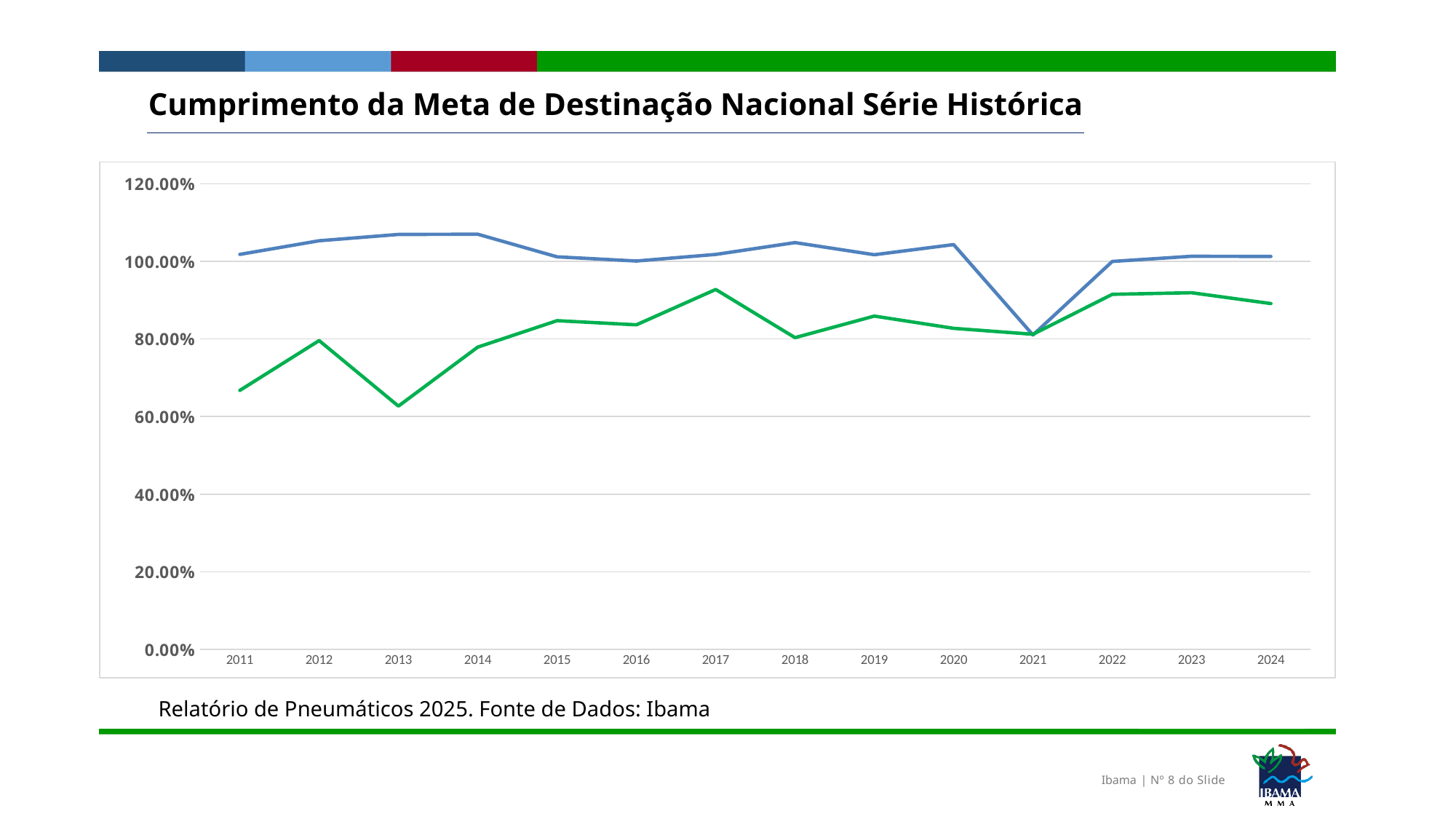
What is the last year shown on the x axis? 2024 Is the value of the green line in 2011 greater or less than 80.00%? less In which year does the green line reach its lowest value? 2013 Is the value of the blue line in 2021 greater or less than 100.00%? less What is the first year shown on the x axis? 2011 In which year does the blue line reach its lowest value? 2021 How many years are shown on the x axis of the chart? 14 How many lines are plotted on the chart? 2 Does the blue line rise or fall from 2020 to 2021? fall What kind of chart is shown on the slide? line chart Is the value of the green line in 2017 greater or less than 80.00%? greater In 2013, which line has the higher value, the blue line or the green line? the blue line